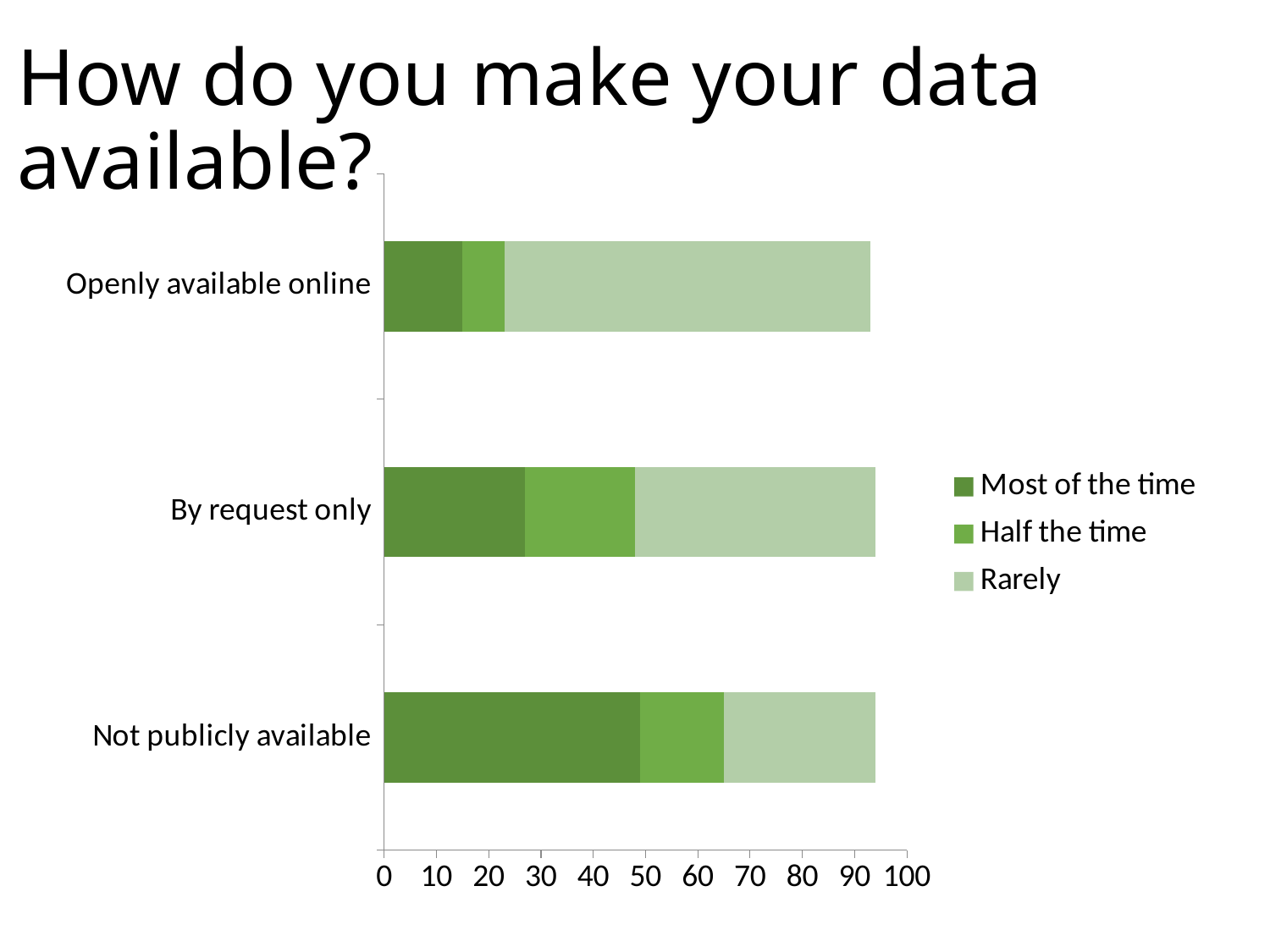
Is the 'Most of the time' value for Openly available online greater or less than 20? less Which category has the largest 'Rarely' segment? Openly available online Is the 'Most of the time' value for Not publicly available greater or less than 40? greater What kind of chart is shown on the slide? Stacked bar chart What are the three series listed in the chart's legend? Most of the time, Half the time, Rarely Which is larger: the 'Most of the time' value for By request only or for Openly available online? By request only What is the title of the chart on the slide? How do you make your data available? Which category has the smallest 'Most of the time' segment? Openly available online Which category has the largest 'Most of the time' segment? Not publicly available How many categories are shown on the vertical axis of the chart? 3 How many series does the chart's legend list? 3 Which category has the smallest 'Rarely' segment? Not publicly available